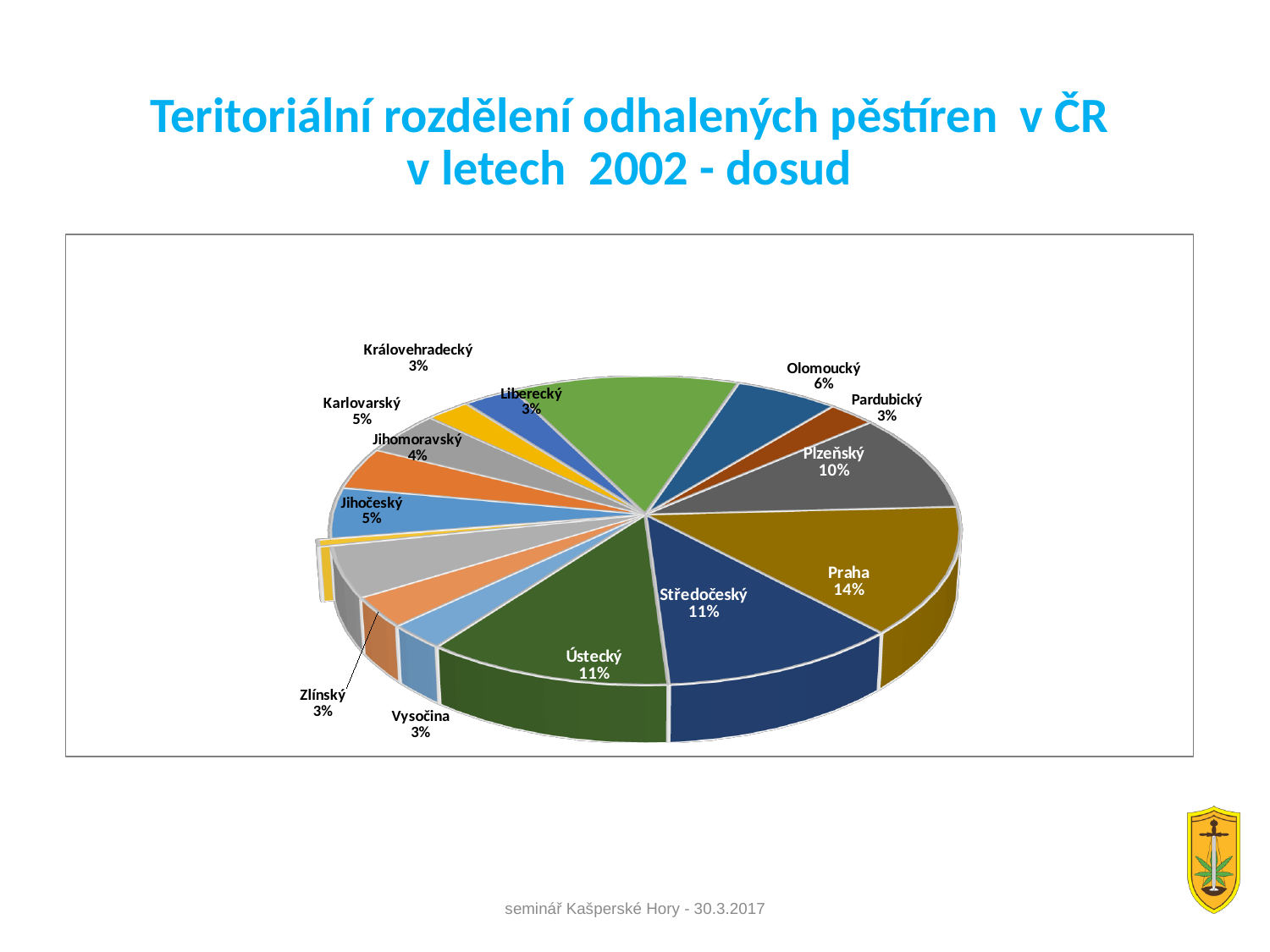
What percentage is labelled for Středočeský? 11% What percentage share does Praha have in the pie chart? 14% What percentage is shown for Karlovarský? 5% What is the difference in percentage points between Praha and Plzeňský? 4 percentage points Which has the larger share, Jihočeský or Liberecký? Jihočeský What is the share shown for Plzeňský? 10% What share does Olomoucký have? 6% What kind of chart is shown on the slide? Pie chart What is the title of the slide containing the chart? Teritoriální rozdělení odhalených pěstíren v ČR v letech 2002 - dosud Which has the larger share, Olomoucký or Pardubický? Olomoucký What is the share for Jihomoravský? 4% What percentage is labelled for Vysočina? 3%